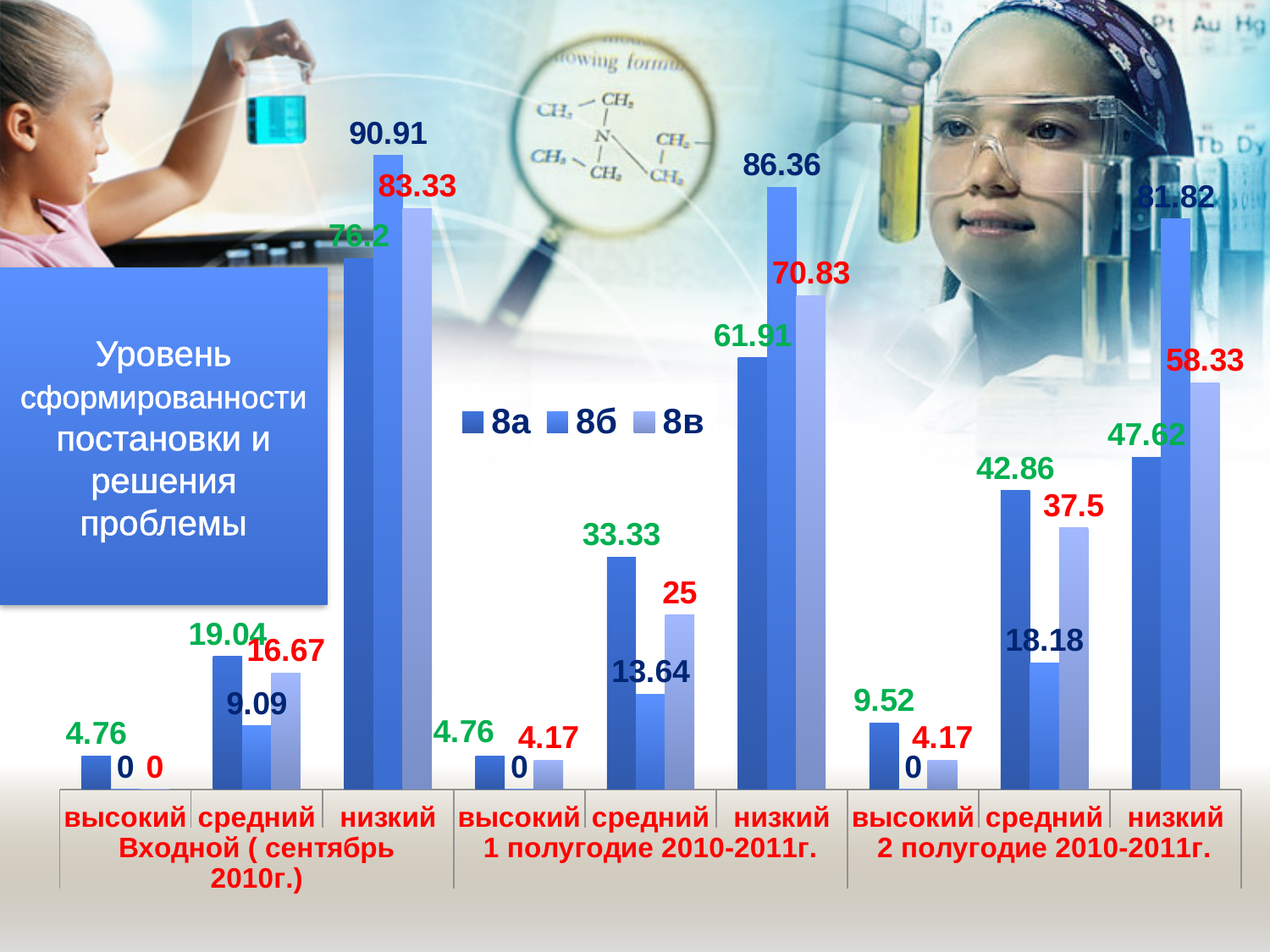
What is the value for 8б in the высокий category of 2 полугодие 2010-2011г.? 0 What is the title of the chart? Уровень сформированности постановки и решения проблемы How does the 8а value in the низкий category change from Входной (сентябрь 2010г.) to 2 полугодие 2010-2011г.? falls What is the value for 8а in the средний category of 1 полугодие 2010-2011г.? 33.33 How many series does the legend list? 3 What is the value for 8в in the низкий category of 2 полугодие 2010-2011г.? 58.33 What is the value for 8б in the низкий category of Входной (сентябрь 2010г.)? 90.91 Which series has the lowest value in the средний category of 2 полугодие 2010-2011г.? 8б Which series has the highest value in the низкий category of 1 полугодие 2010-2011г.? 8б What is the difference between the 8а and 8б values in the средний category of Входной (сентябрь 2010г.)? 9.95 What type of chart is shown on the slide? bar chart Which is larger: the 8а value or the 8в value in the средний category of 1 полугодие 2010-2011г.? 8а